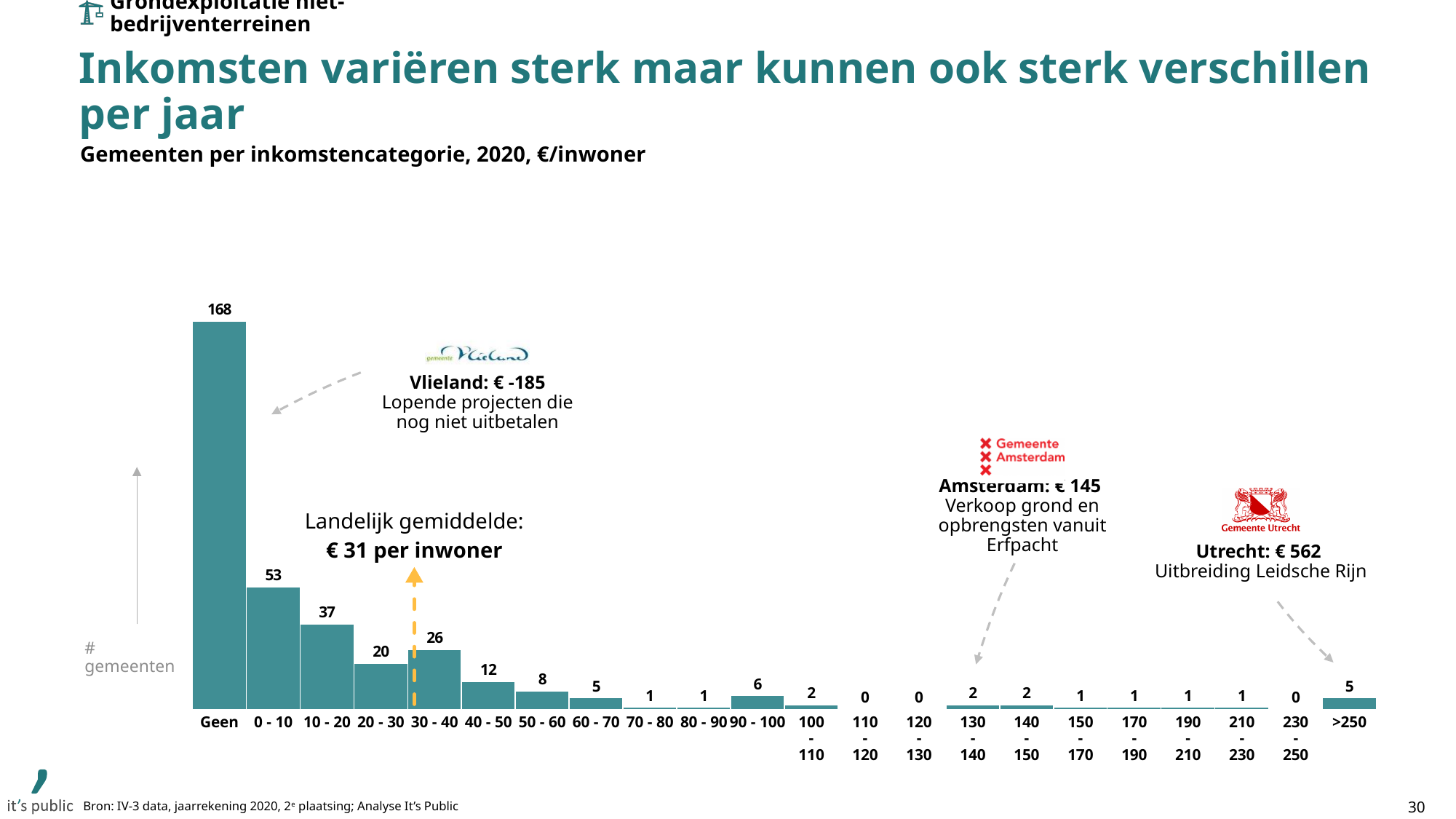
How many income categories are shown on the x axis? 22 Which category has more municipalities, '20 - 30' or '30 - 40'? 30 - 40 What is the value shown for the '30 - 40' category? 26 How many municipalities are in the 'Geen' category? 168 What is the difference between the number of municipalities in '0 - 10' and '10 - 20'? 16 What is the total number of municipalities in the '90 - 100' and '100 - 110' categories combined? 8 How many municipalities are in the '>250' category? 5 What is the national average (Landelijk gemiddelde) income per inhabitant indicated on the chart? € 31 per inwoner Which income category has the highest number of municipalities? Geen How many municipalities fall in the '0 - 10' income category? 53 What income per inhabitant is annotated for Utrecht on the chart? € 562 What type of chart is shown on the slide? Bar chart